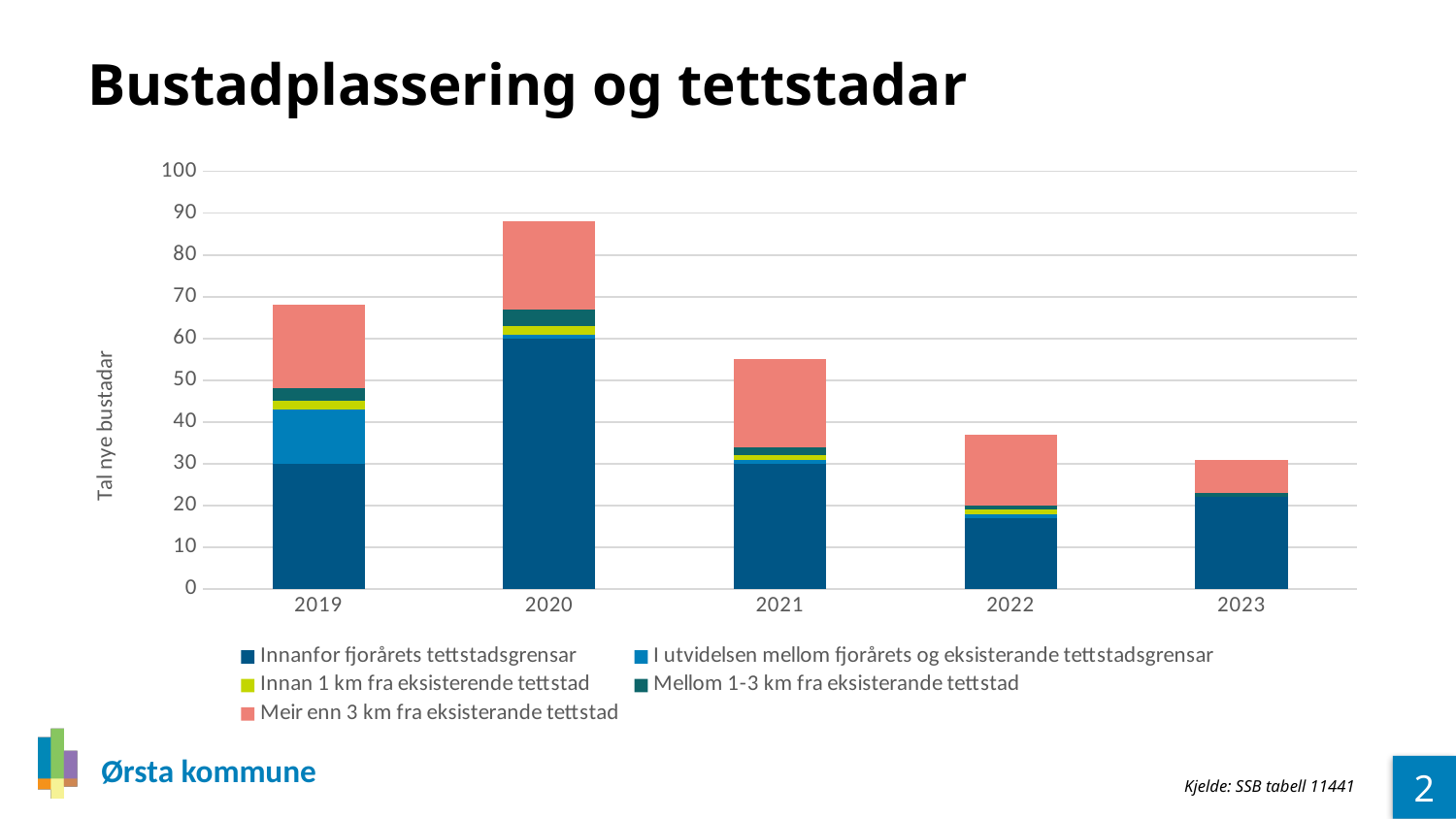
Is the total for 2021 greater or less than 50? greater Do the total bar heights rise or fall from 2020 to 2023? fall How many years are shown on the x axis of the chart? 5 Is the total for 2019 greater or less than 70? less Which year has the lowest total number of new dwellings? 2023 What kind of chart is shown on the slide? Stacked bar chart How many series does the legend list? 5 Is the total for 2022 greater or less than 40? less What is the title of the y axis? Tal nye bustadar Which year has the larger total, 2019 or 2021? 2019 Which year has the highest total number of new dwellings? 2020